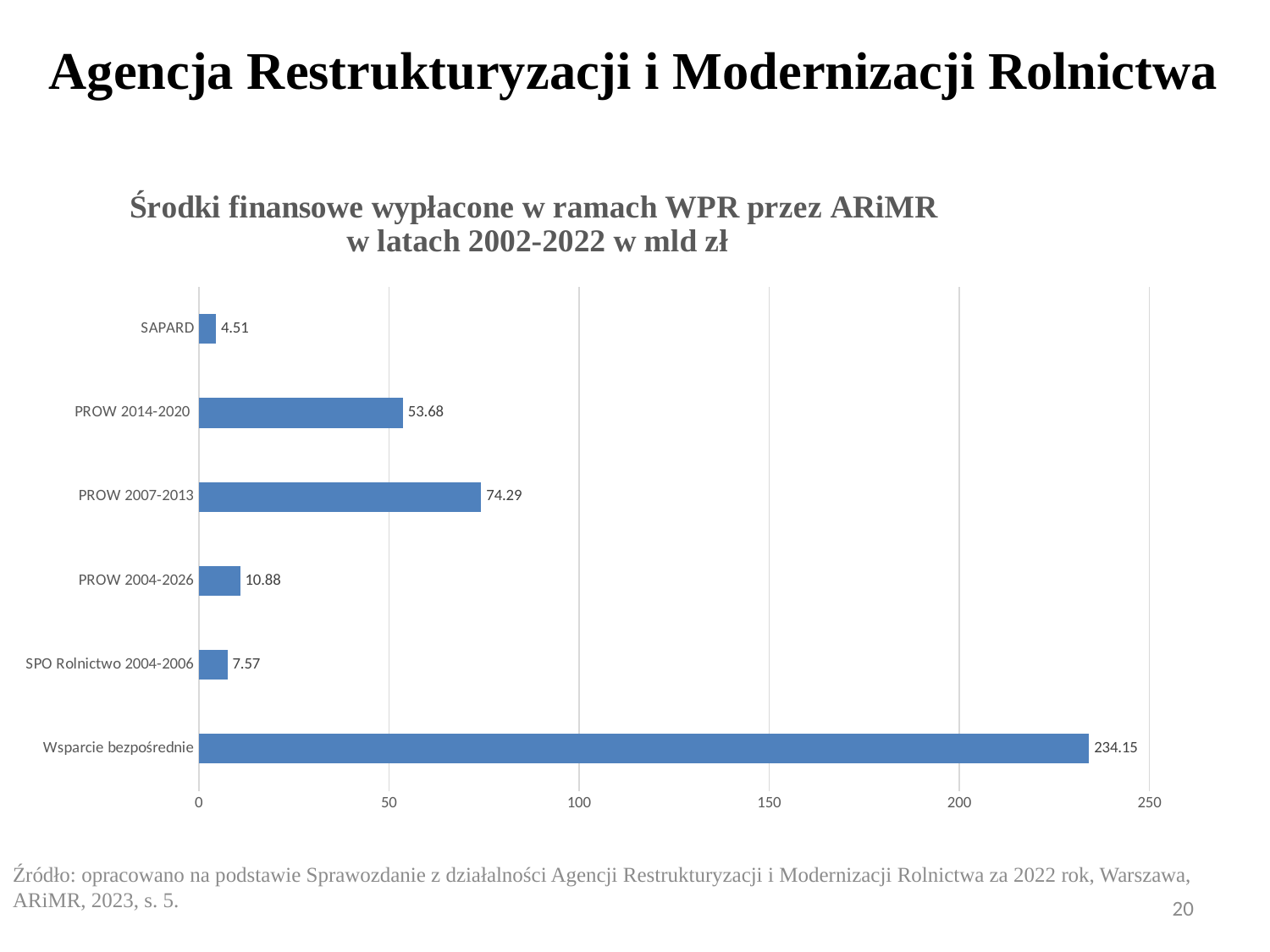
How many categories are shown in the chart? 6 What is the value for SAPARD? 4.51 Which category has the highest value? Wsparcie bezpośrednie What is the value for SPO Rolnictwo 2004-2006? 7.57 Which category has the lowest value? SAPARD Which is larger, the value for PROW 2004-2026 or the value for SPO Rolnictwo 2004-2006? PROW 2004-2026 What is the value for PROW 2007-2013? 74.29 What is the title of the chart? Środki finansowe wypłacone w ramach WPR przez ARiMR w latach 2002-2022 w mld zł Is the value for PROW 2014-2020 greater or less than 50? greater What is the value for Wsparcie bezpośrednie? 234.15 What is the difference between the values for PROW 2007-2013 and PROW 2014-2020? 20.61 What kind of chart is shown on the slide? bar chart